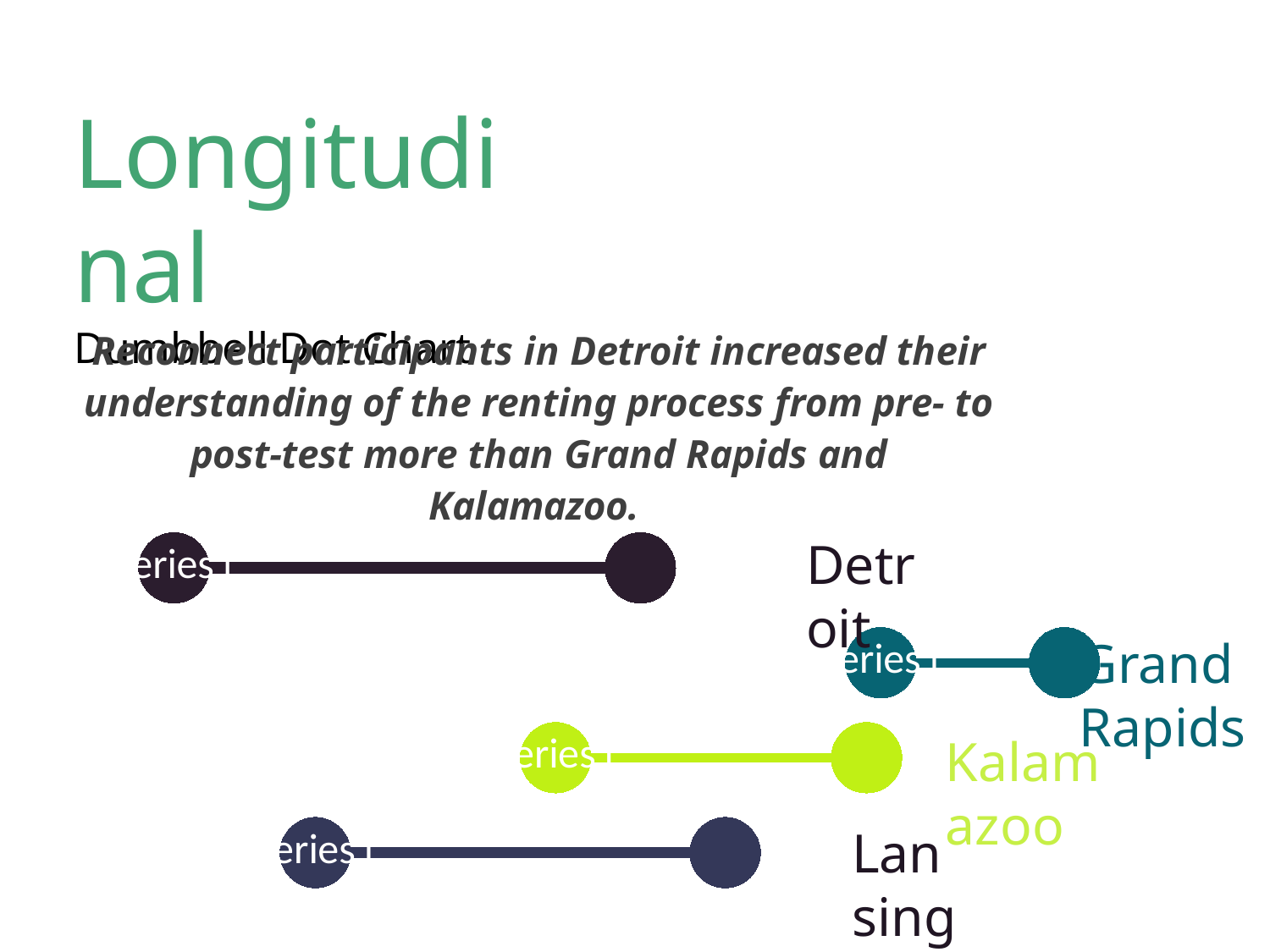
Which city has the shortest dumbbell (smallest change from pre- to post-test) in the chart? Grand Rapids Which city shows a larger change from pre- to post-test, Lansing or Kalamazoo? Lansing Which city shows a larger change from pre- to post-test, Kalamazoo or Grand Rapids? Kalamazoo Which city is listed at the top of the dumbbell dot chart? Detroit How many cities are shown in the dumbbell dot chart? 4 What colour is the dumbbell for Kalamazoo? Lime green Which city is listed at the bottom of the dumbbell dot chart? Lansing Which city has the longest dumbbell (largest change from pre- to post-test) in the chart? Detroit According to the slide's caption, which city's participants increased their understanding of the renting process the most? Detroit What kind of chart is shown on the slide? Dumbbell dot chart Which city shows a larger change from pre- to post-test, Detroit or Kalamazoo? Detroit